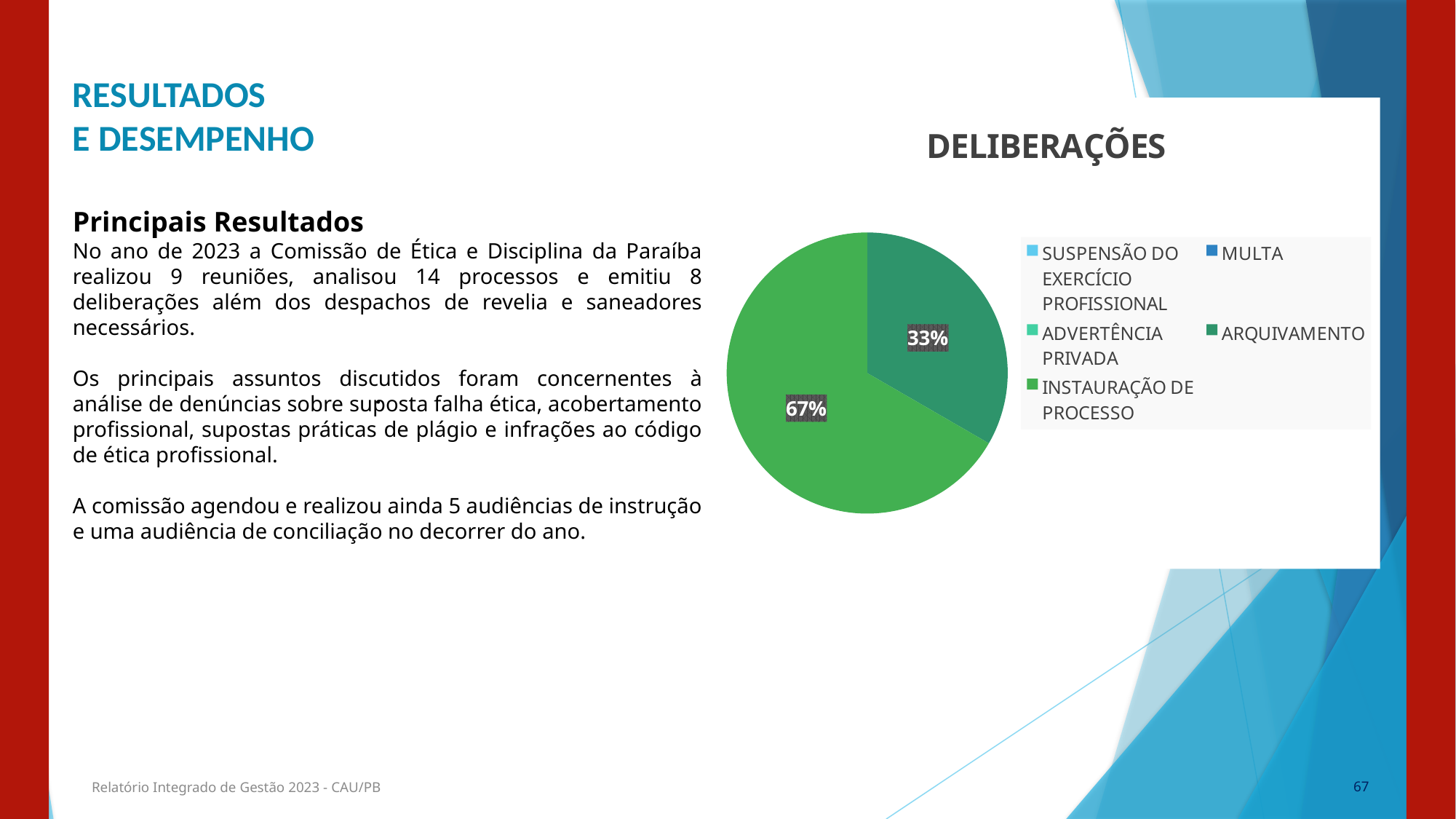
Which category has the largest slice of the pie? INSTAURAÇÃO DE PROCESSO Which legend entry is shown in dark blue? MULTA What share of the pie does ARQUIVAMENTO represent? 33% Which of the two labelled slices is smaller, INSTAURAÇÃO DE PROCESSO or ARQUIVAMENTO? ARQUIVAMENTO What kind of chart is shown on the slide? pie chart What is the title of the pie chart? DELIBERAÇÕES How many slices with data labels are visible in the pie chart? 2 Is the share for ARQUIVAMENTO greater or less than 50%? less How many categories are listed in the legend of the pie chart? 5 What share of the pie does INSTAURAÇÃO DE PROCESSO represent? 67% What is the difference in percentage points between the INSTAURAÇÃO DE PROCESSO slice and the ARQUIVAMENTO slice? 34%